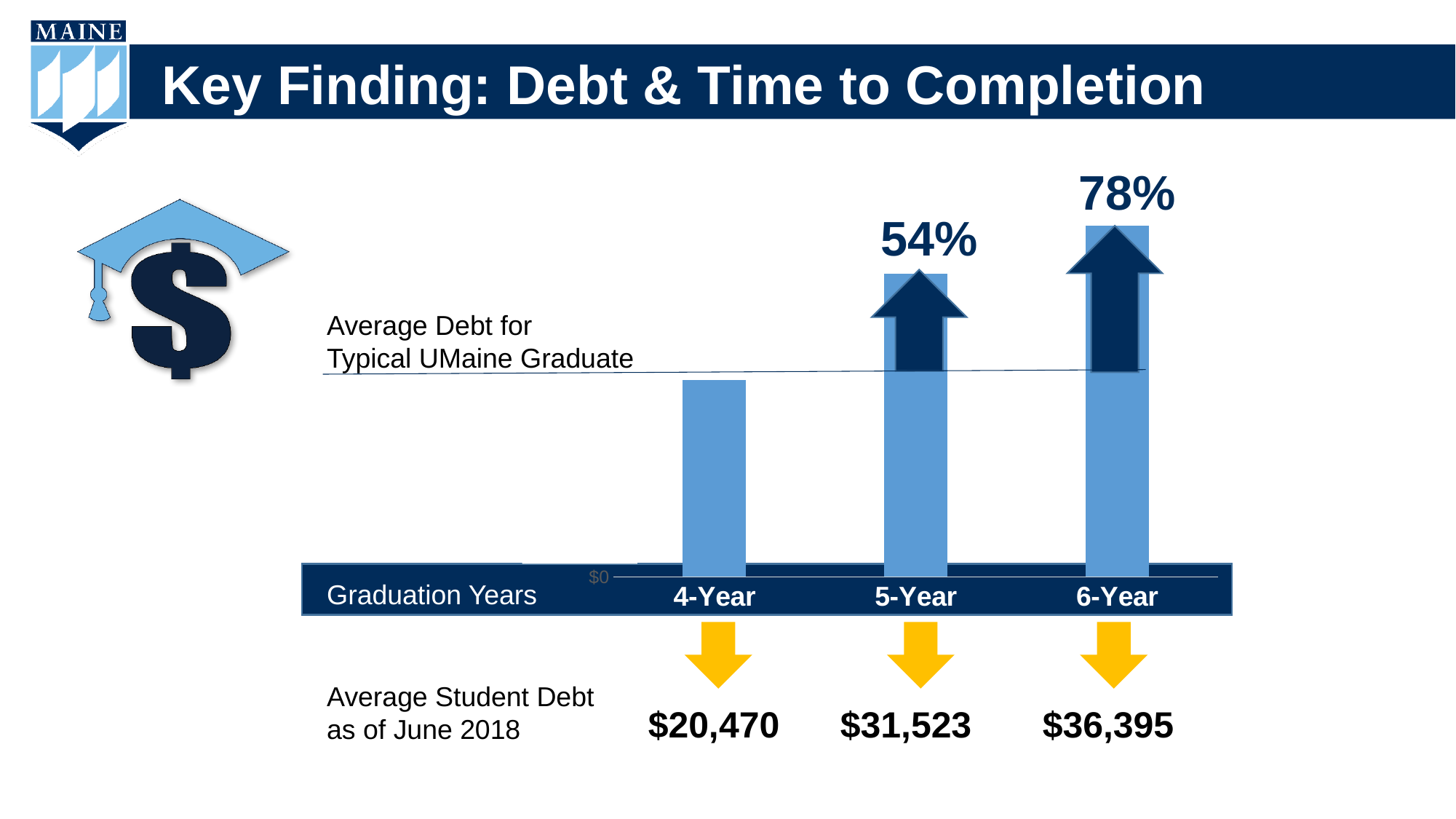
Which graduation-year category has the lowest average student debt? 4-Year What percentage is shown above the 5-Year bar? 54% What is the difference in average student debt between 5-Year and 4-Year graduates? $11,053 What is the average student debt as of June 2018 for 6-Year graduates? $36,395 What is the average student debt as of June 2018 for 4-Year graduates? $20,470 How many graduation-year categories are shown in the chart? 3 Does average student debt rise or fall as graduation years increase from 4-Year to 6-Year? Rise What percentage is shown above the 6-Year bar? 78% What kind of chart is used to show average debt by graduation years? Bar chart What is the average student debt as of June 2018 for 5-Year graduates? $31,523 What is the difference in average student debt between 6-Year and 4-Year graduates? $15,925 Which graduation-year category has the highest average student debt? 6-Year